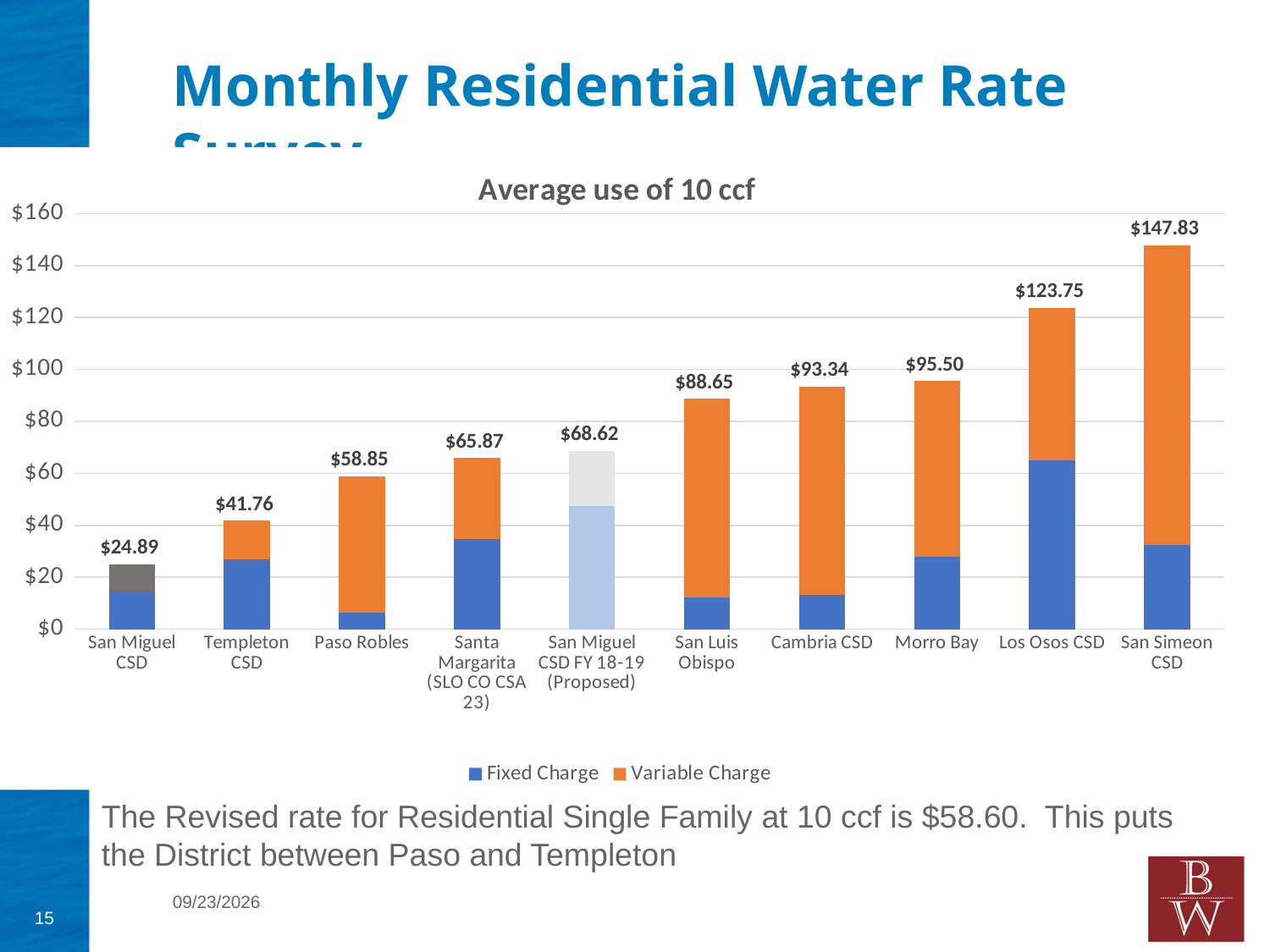
Is the Fixed Charge for Los Osos CSD greater or less than $40? greater What is the difference between the total rates for Los Osos CSD and Morro Bay? $28.25 How many series does the legend list? 2 Which category has the lowest total monthly rate? San Miguel CSD How many categories are shown on the x axis of the chart? 10 What is the total monthly rate shown for San Simeon CSD? $147.83 Is the Fixed Charge for Paso Robles greater or less than $20? less What is the total monthly rate shown for Templeton CSD? $41.76 What is the total monthly rate shown for San Miguel CSD FY 18-19 (Proposed)? $68.62 Which category has the highest total monthly rate? San Simeon CSD Which has a higher total monthly rate, Cambria CSD or San Luis Obispo? Cambria CSD What type of chart is shown on the slide? Stacked bar chart